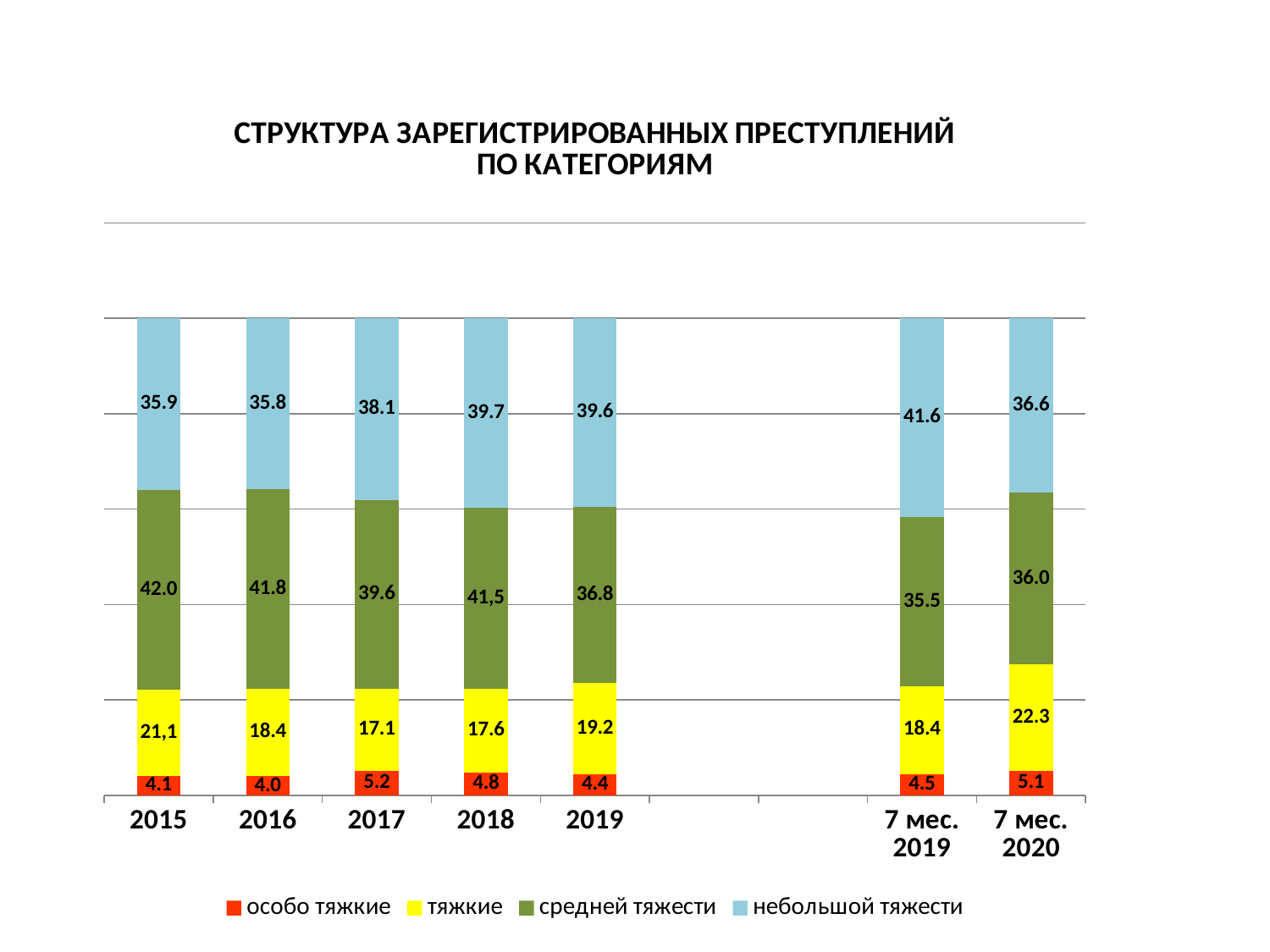
What is the difference between the 'средней тяжести' values for 2015 and 2019? 5.2 What is the total of the stacked bar for 2016? 100.0 In which category does the 'особо тяжкие' segment have its highest value? 2017 In which category does the 'тяжкие' segment have its lowest value? 2017 In which category does the 'небольшой тяжести' segment have its highest value? 7 мес. 2019 What is the value of the 'тяжкие' segment for 2015? 21,1 What is the value of the 'средней тяжести' segment for 7 мес. 2020? 36.0 How many categories are shown on the x axis? 7 What kind of chart is shown on the slide? Stacked bar chart How many series does the legend list? 4 What is the value of the 'небольшой тяжести' segment for 2017? 38.1